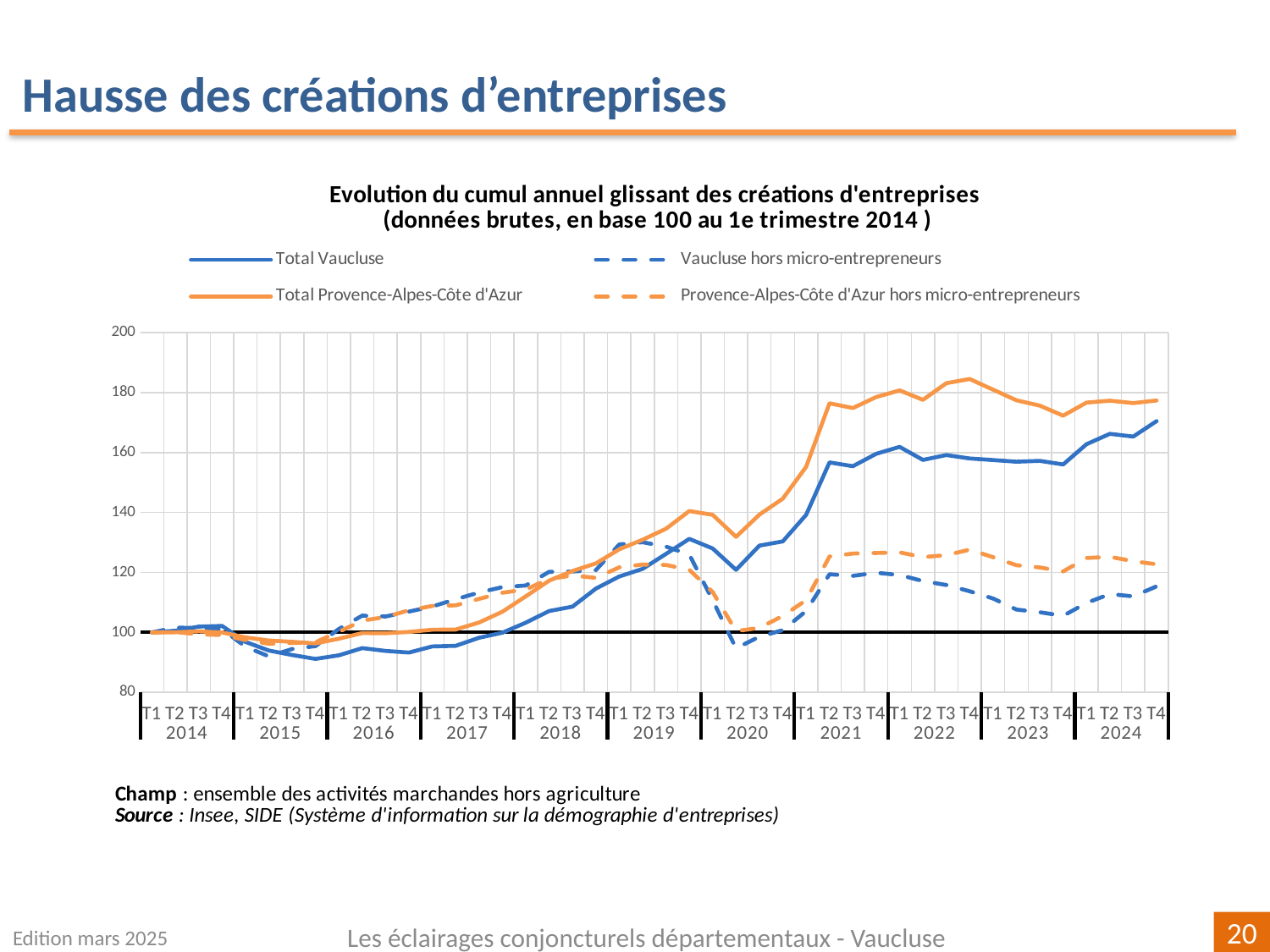
What is the title of the chart? Evolution du cumul annuel glissant des créations d'entreprises (données brutes, en base 100 au 1e trimestre 2014 ) How many series does the chart legend list? 4 Which series has the lowest value at T4 2024? Vaucluse hors micro-entrepreneurs At T4 2024, which is higher: Total Provence-Alpes-Côte d'Azur or Total Vaucluse? Total Provence-Alpes-Côte d'Azur What kind of chart is shown on the slide? Line chart Overall, does the Total Vaucluse series rise or fall between 2014 and 2024? Rise Is the value for Total Vaucluse at T4 2015 greater or less than 100? less Is the value for Total Provence-Alpes-Côte d'Azur at T4 2024 greater or less than 160? greater How many years are shown along the x axis of the chart? 11 Which series has the highest value at T4 2024? Total Provence-Alpes-Côte d'Azur What is the value of the series at T1 2014, the base period of the index? 100 Is the value for Vaucluse hors micro-entrepreneurs at T4 2024 greater or less than 120? less